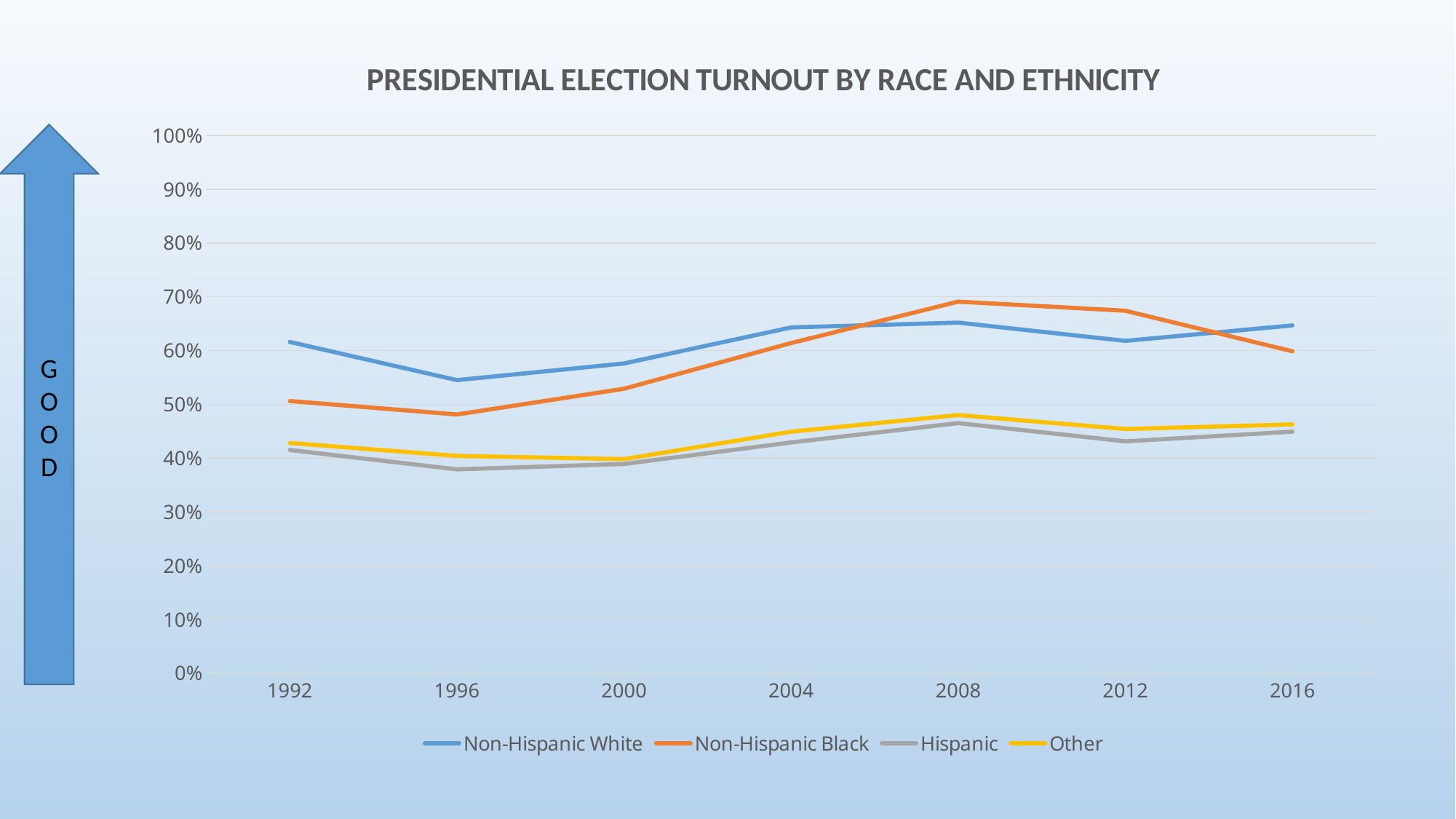
Does the Non-Hispanic Black series rise or fall from 2008 to 2016? Fall In which year does the Non-Hispanic Black series reach its highest value? 2008 What is the title of the chart? PRESIDENTIAL ELECTION TURNOUT BY RACE AND ETHNICITY What kind of chart is shown on the slide? Line chart In 2008, which is higher: Non-Hispanic Black or Non-Hispanic White? Non-Hispanic Black Which series has the lowest turnout in 1996? Hispanic In 2016, which is higher: Non-Hispanic White or Non-Hispanic Black? Non-Hispanic White Is the value for Non-Hispanic Black in 2008 greater or less than 60%? greater How many series does the legend list? 4 Which series has the highest turnout in 1992? Non-Hispanic White How many election years are plotted along the x axis? 7 Is the value for Hispanic in 1996 greater or less than 40%? less